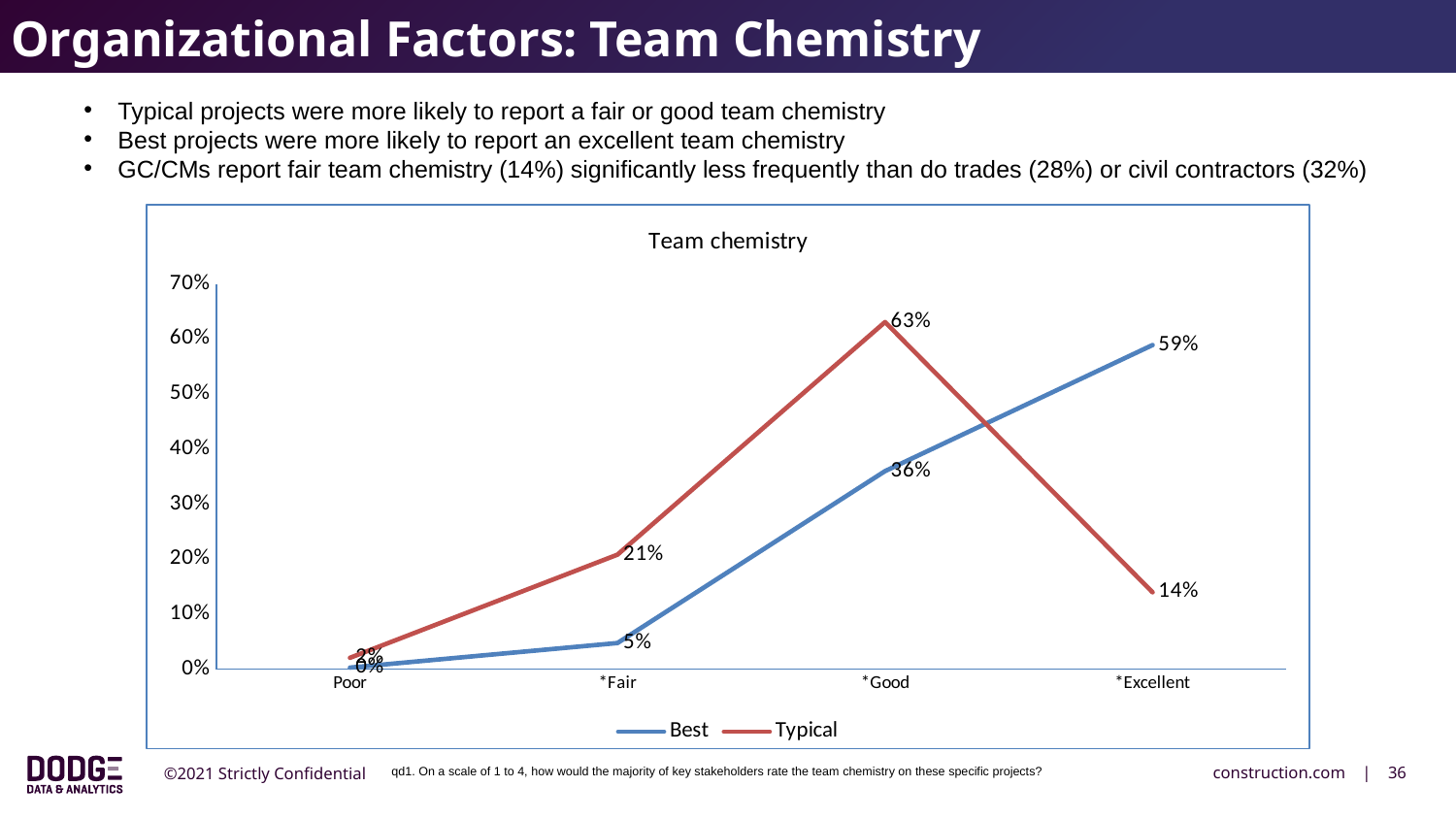
At which category does the Typical series reach its highest value? *Good Which series has the larger value at *Excellent, Best or Typical? Best What is the value for Typical at *Excellent? 14% At which category does the Best series reach its highest value? *Excellent What kind of chart is shown on the slide? Line chart How many categories are shown on the x axis? 4 What is the difference between Typical and Best at *Good? 27% What is the value for Best at *Excellent? 59% What is the value for Typical at *Fair? 21% What is the value for Best at *Good? 36% What is the value for Typical at *Good? 63% How many series does the legend list? 2